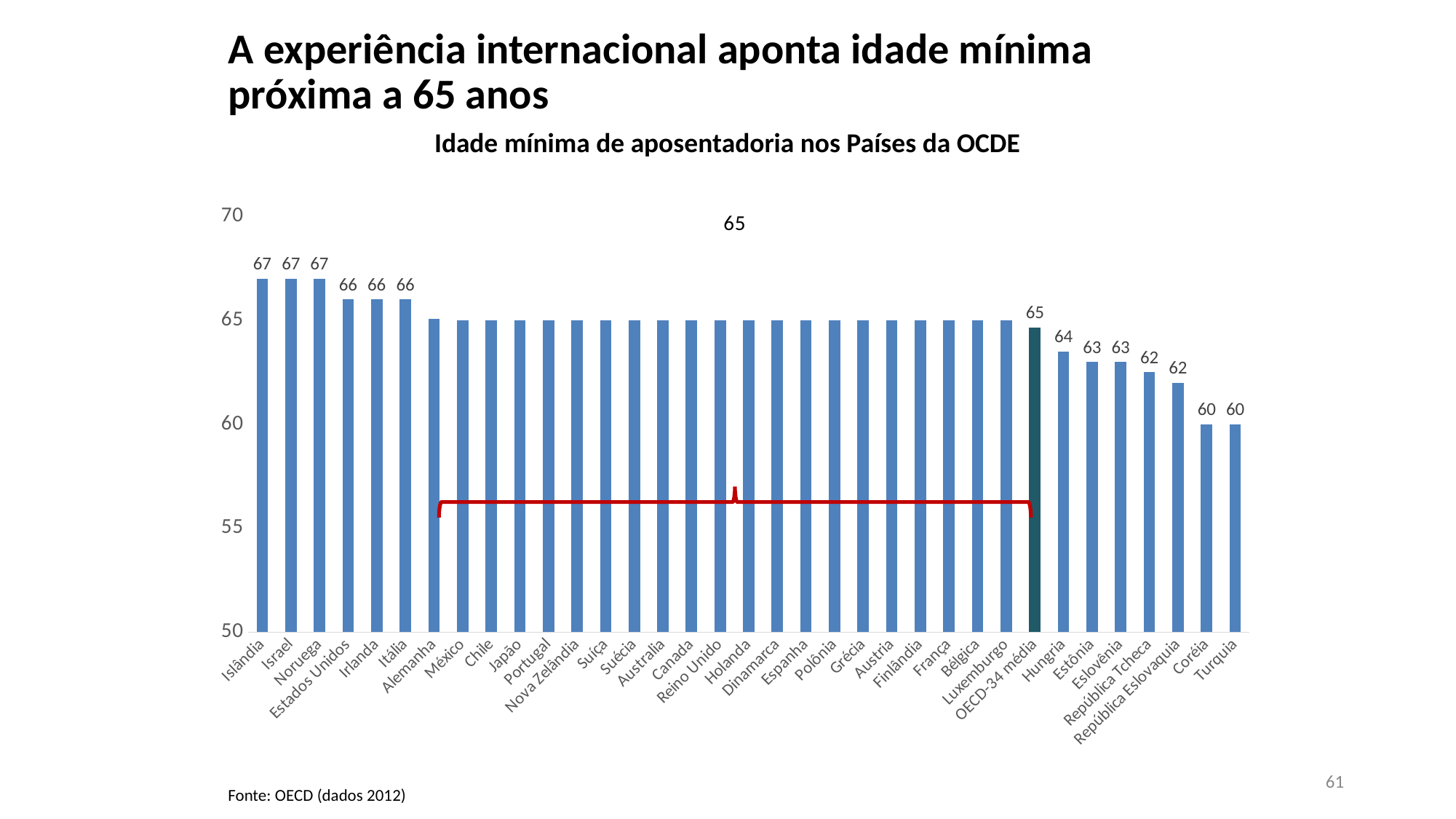
What value is shown for Islândia? 67 What kind of chart is shown on the slide? bar chart What is the difference between the values for Islândia and Turquia? 7 What is the highest value shown in the chart? 67 What is the value shown for OECD-34 média? 65 Which bar is drawn in a darker colour than the others? OECD-34 média Is the value for Alemanha greater or less than 60? greater What is the minimum retirement age shown for Hungria? 64 What is the difference between the values for Hungria and Coréia? 4 Do the values generally rise or fall from left to right along the x axis? fall Which has a higher value, Estados Unidos or Estônia? Estados Unidos What value is shown for Turquia? 60